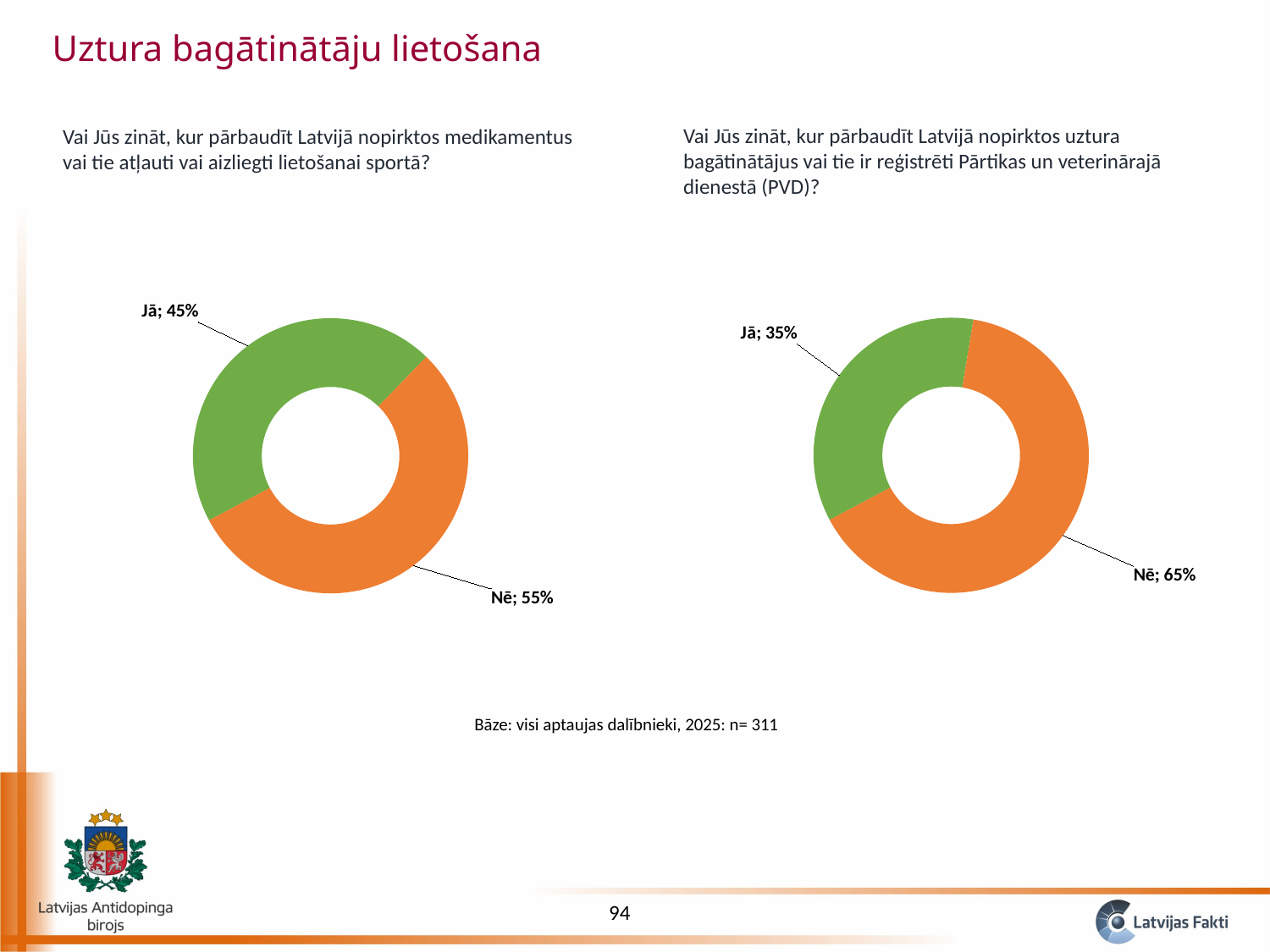
In the left chart (about medicines), what is the value for "Nē"? 55% In the right chart, which category has the smaller share? Jā What kind of chart is the right chart? Doughnut (pie) chart What colour is the "Nē" segment in the left chart? Orange In the right chart (about uztura bagātinātāji / PVD), what is the value for "Jā"? 35% In the left chart, which category has the larger share? Nē In the right chart, what is the difference between the "Nē" and "Jā" values? 30% Is the "Jā" value larger in the left chart or in the right chart? Left chart In the left chart, what is the difference between the "Nē" and "Jā" values? 10% How many categories does the left chart show? 2 In the right chart (about uztura bagātinātāji / PVD), what is the value for "Nē"? 65% In the left chart (about medicines), what is the value for "Jā"? 45%